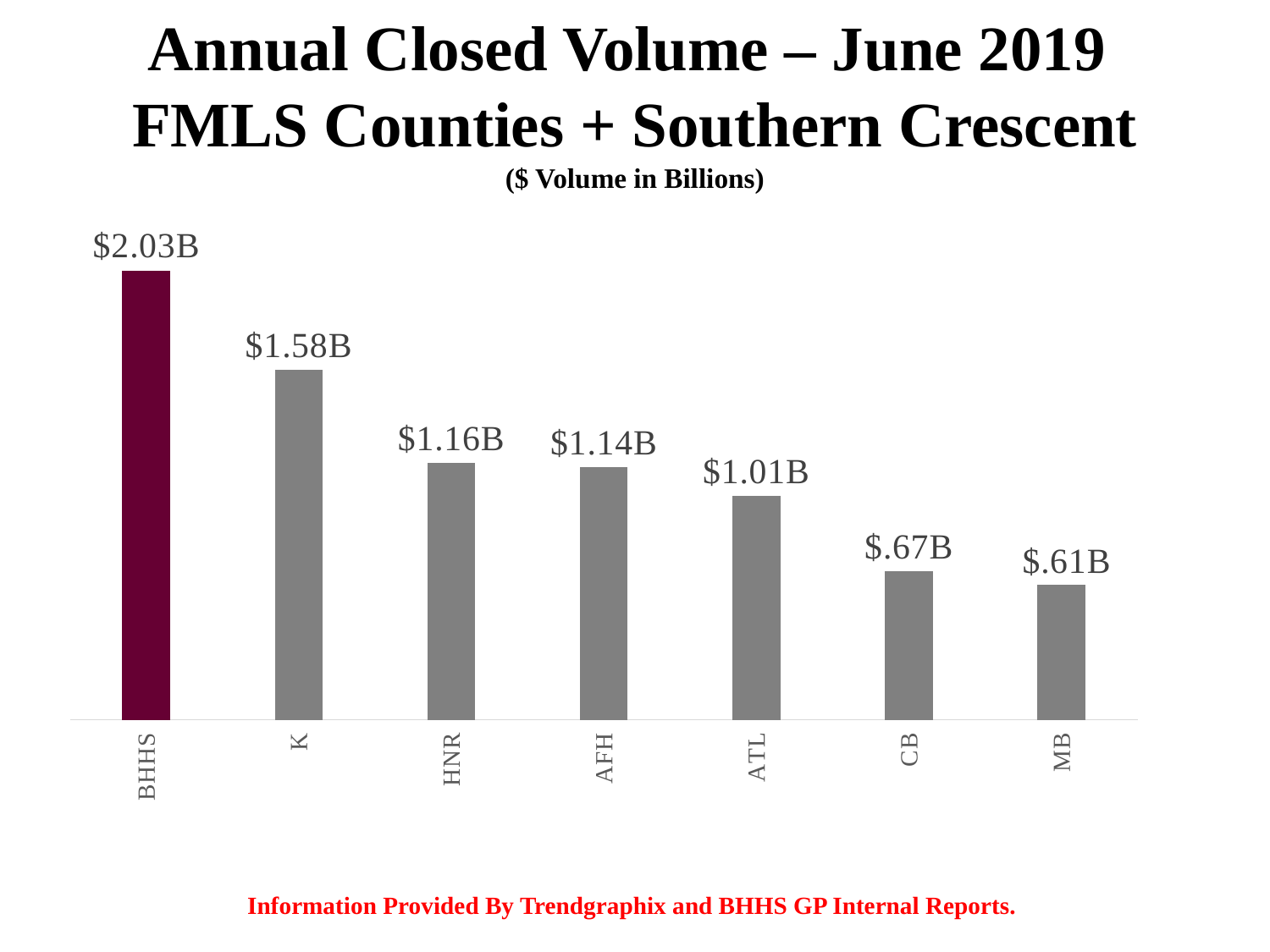
Which category has the lowest annual closed volume? MB What is the annual closed volume for HNR? $1.16B Which has a larger closed volume, ATL or AFH? AFH What is the annual closed volume for BHHS? $2.03B Which category has the highest annual closed volume? BHHS What is the difference between the closed volume of CB and MB? $.06B What is the annual closed volume for CB? $.67B What kind of chart is shown on the slide? Bar chart What is the difference between the closed volume of BHHS and K? $.45B Do the values rise or fall from left to right across the chart? Fall How many categories are shown in the chart? 7 Which bar is shown in a different colour from the others? BHHS